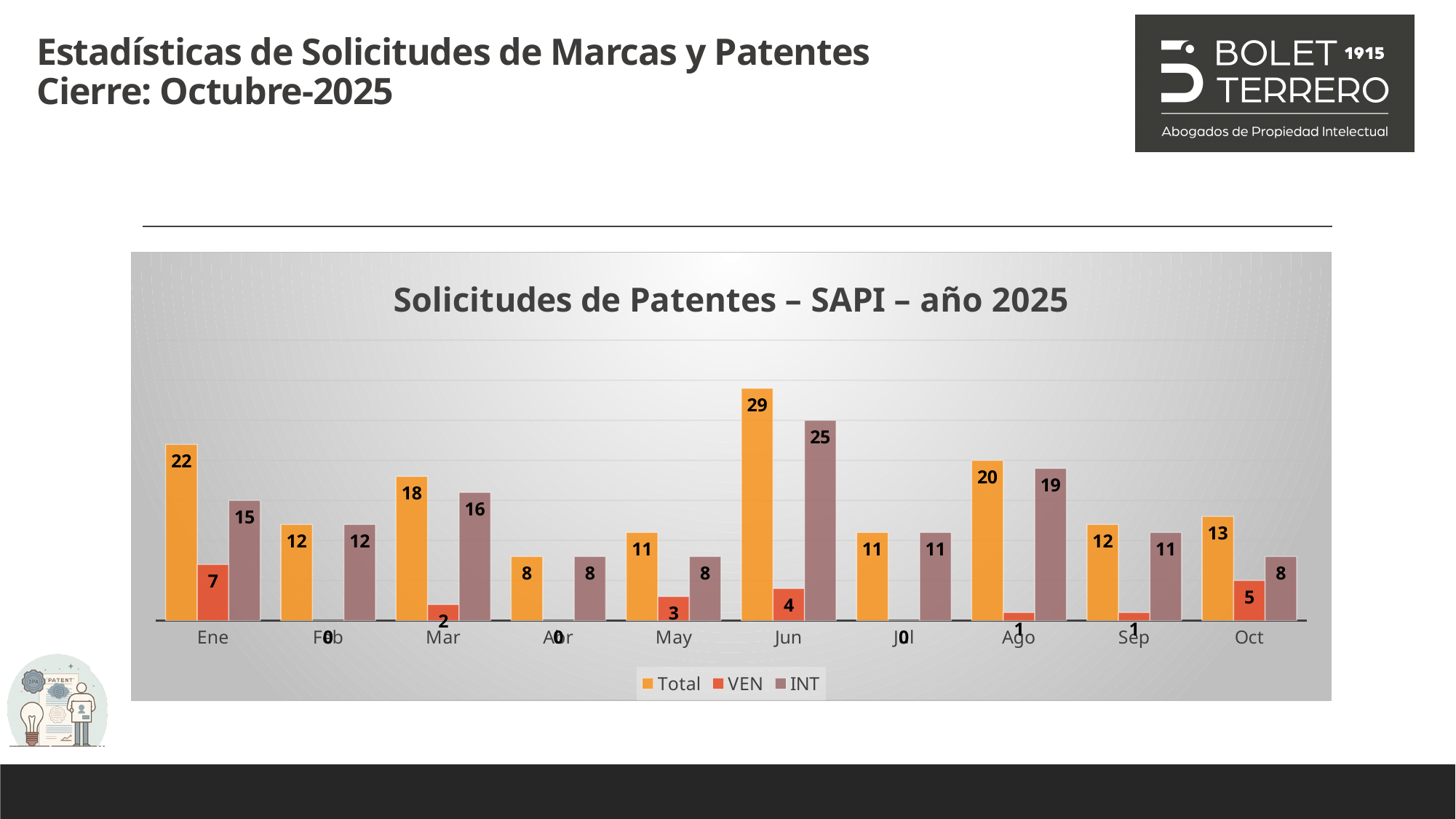
Which month has the lowest Total value? Abr How many series does the legend list? 3 What is the INT value for Ago? 19 How many months are shown on the x axis? 10 What is the Total value for Jun? 29 What is the VEN value for Ene? 7 Which is larger, the INT value for Ene or the INT value for Mar? INT for Mar What is the title of the chart? Solicitudes de Patentes – SAPI – año 2025 Which month has the highest Total value? Jun What kind of chart is shown on the slide? Bar chart What is the difference between the Total and INT values for Mar? 2 What is the VEN value for Oct? 5